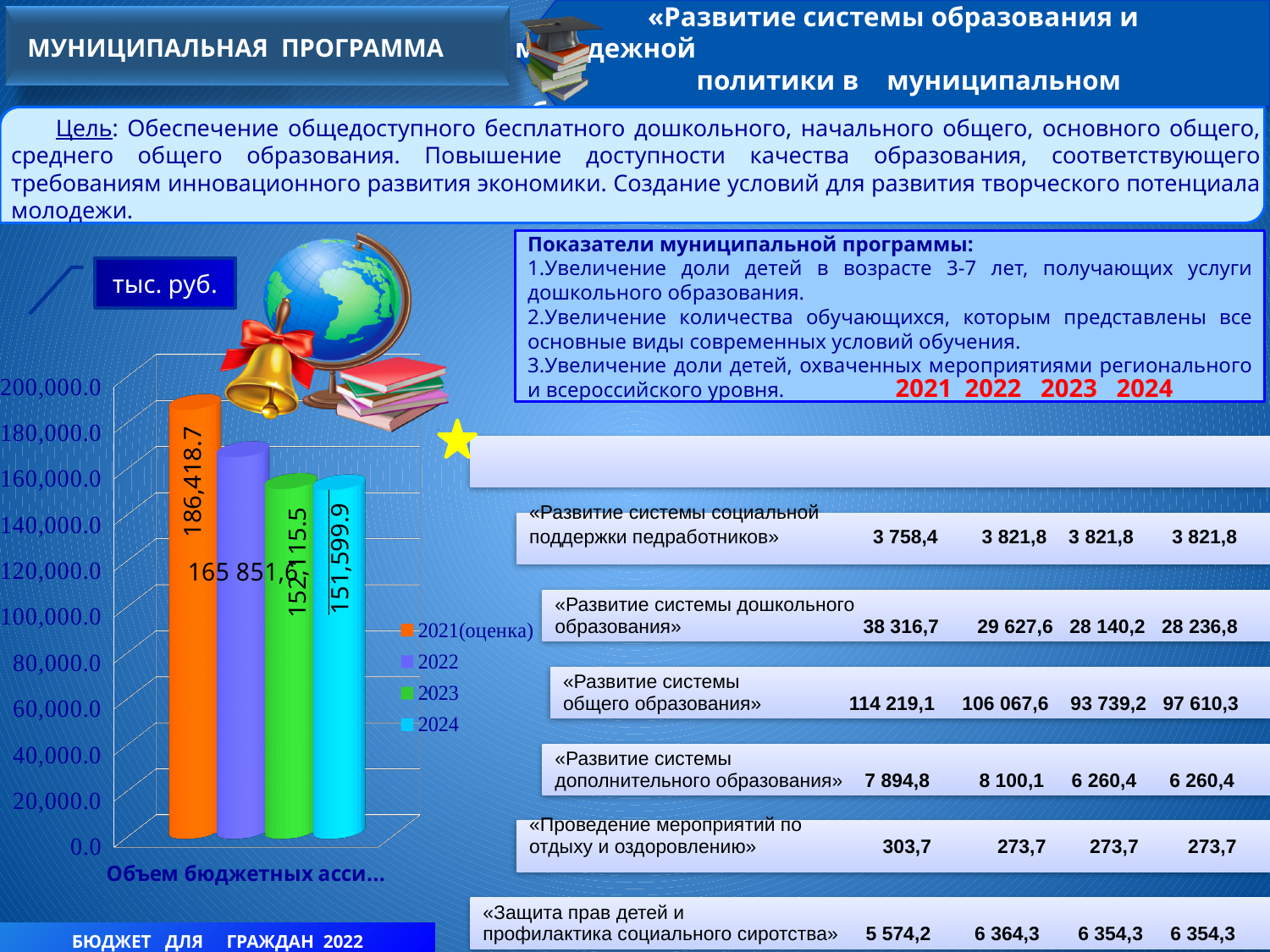
Which year has the lowest bar in the chart? 2024 What is the value of the bar for 2023? 152,115.5 What is the difference between the values for 2021(оценка) and 2023? 34,303.2 How many entries does the chart legend list? 4 How many bars are plotted in the chart? 4 Is the value for 2022 greater or less than 180,000.0? less What kind of chart is shown on the left of the slide? bar chart Which year has the highest bar in the chart? 2021(оценка) Do the bar values rise or fall from 2021(оценка) to 2024? fall What is the value of the bar for 2021(оценка)? 186,418.7 Which is larger, the value for 2021(оценка) or the value for 2022? 2021(оценка) What is the value of the bar for 2024? 151,599.9